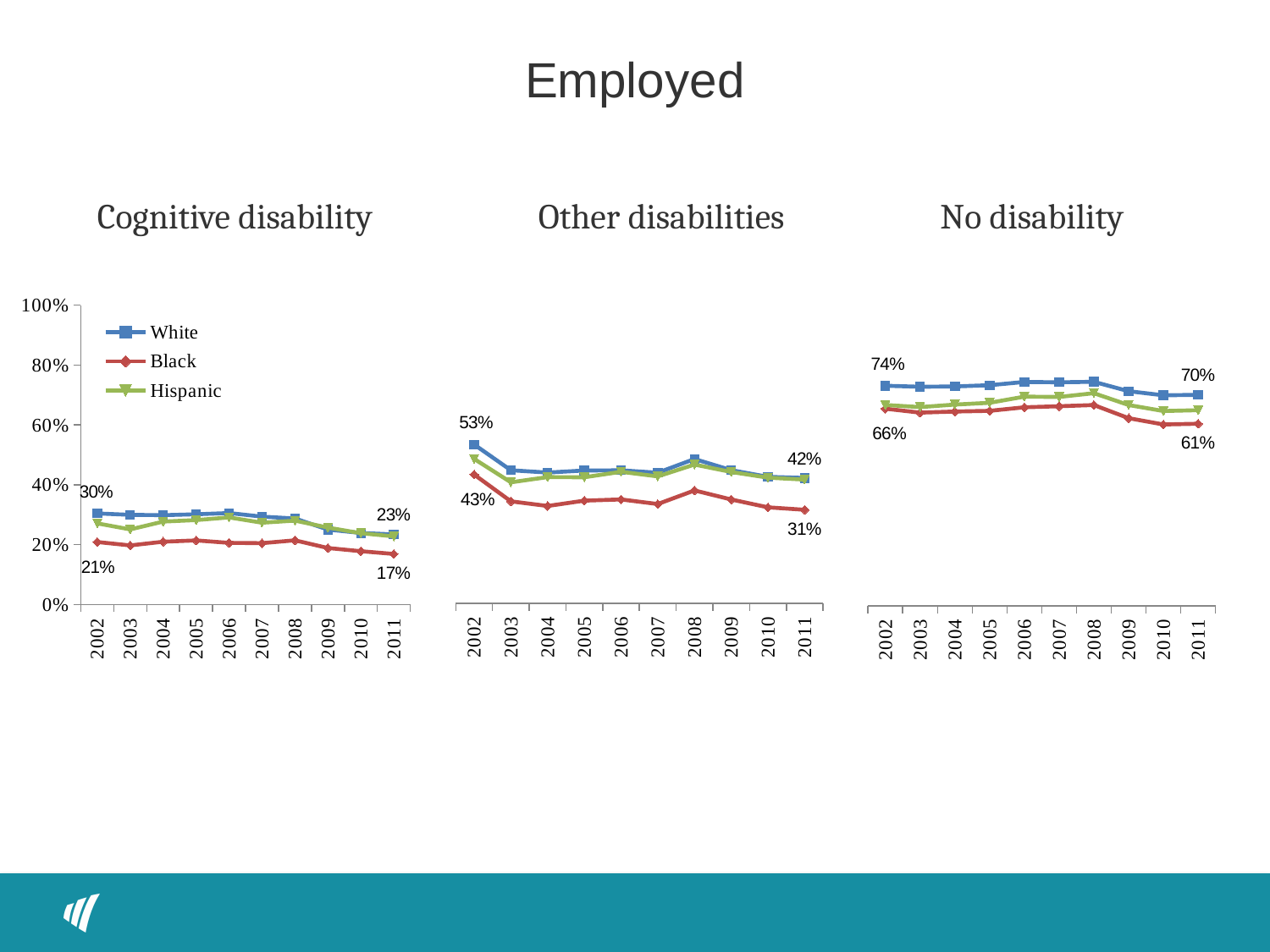
How many series does the legend on the Cognitive disability chart list? 3 In the No disability chart, what is the value for White in 2011? 70% How many years are shown on the x axis of the No disability chart? 10 What kind of chart is the Other disabilities chart? line chart In the Cognitive disability chart, does the White series rise or fall from 2002 to 2011? fall In the Cognitive disability chart, what is the value for White in 2002? 30% In the Other disabilities chart, what is the value for White in 2002? 53% In the Cognitive disability chart, what is the value for Black in 2011? 17% In the Other disabilities chart, by how much did the White value fall from 2002 to 2011? 11% In the Cognitive disability chart, which is larger in 2011: the White value or the Black value? White In the Other disabilities chart, what is the value for Black in 2011? 31% In the No disability chart, what is the difference between the White value in 2002 and the Black value in 2002? 8%